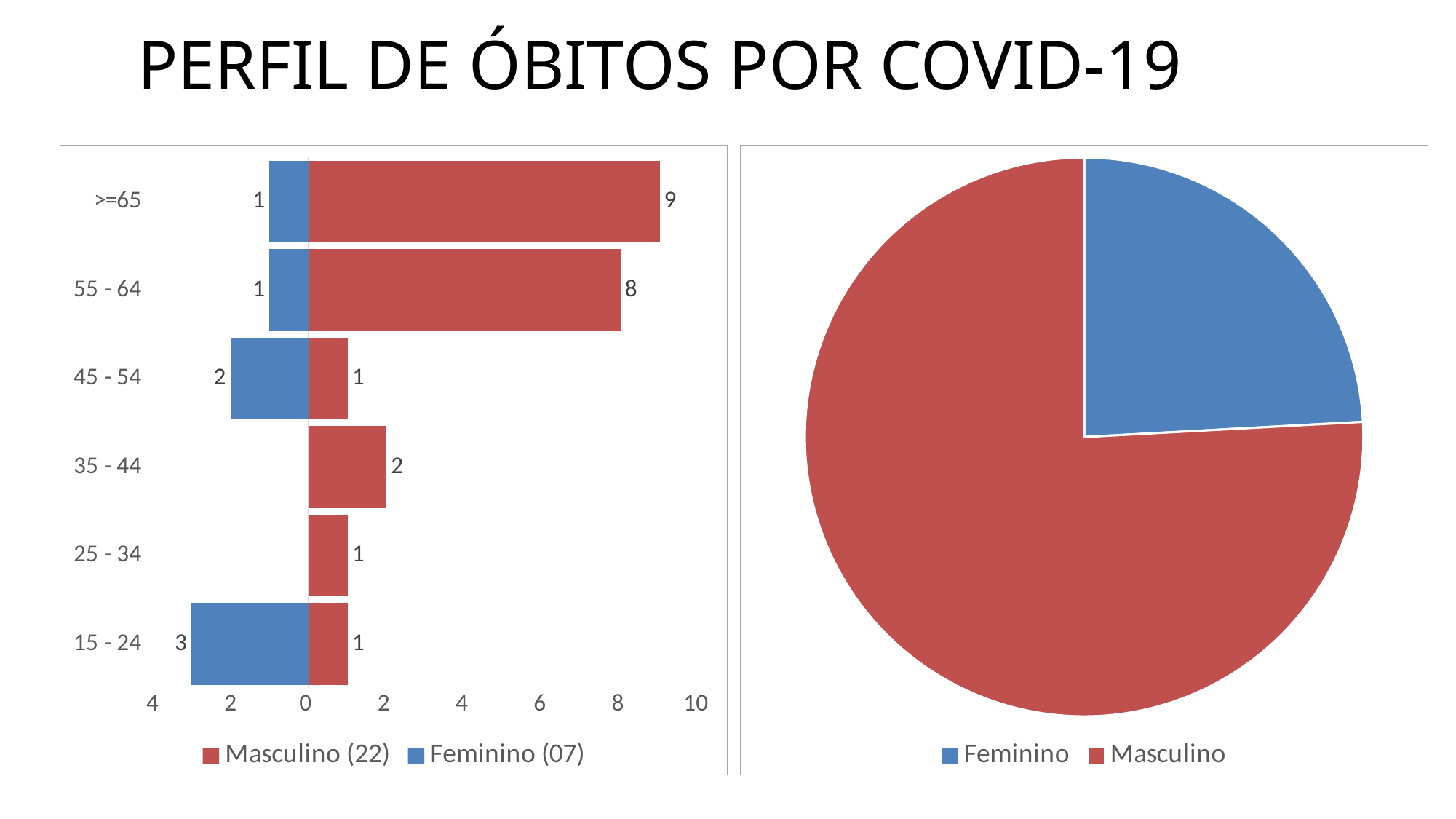
What type of chart is shown on the right side of the slide? Pie chart In the bar chart on the left, what is the Masculino value for the >=65 age group? 9 In the bar chart on the left, which is larger for the 45 - 54 age group, the Masculino value or the Feminino value? Feminino In the pie chart on the right, which slice is larger, Feminino or Masculino? Masculino In the bar chart on the left, which age group has the highest Feminino value? 15 - 24 In the bar chart on the left, what is the Feminino value for the 15 - 24 age group? 3 In the bar chart on the left, what is the difference between the Masculino values for >=65 and 55 - 64? 1 In the bar chart on the left, which age group has the highest Masculino value? >=65 How many age groups are shown in the bar chart on the left? 6 In the bar chart on the left, what is the difference between the Masculino and Feminino values for the 45 - 54 age group? 1 How many series does the legend of the bar chart on the left list? 2 In the bar chart on the left, what is the Masculino value for the 55 - 64 age group? 8